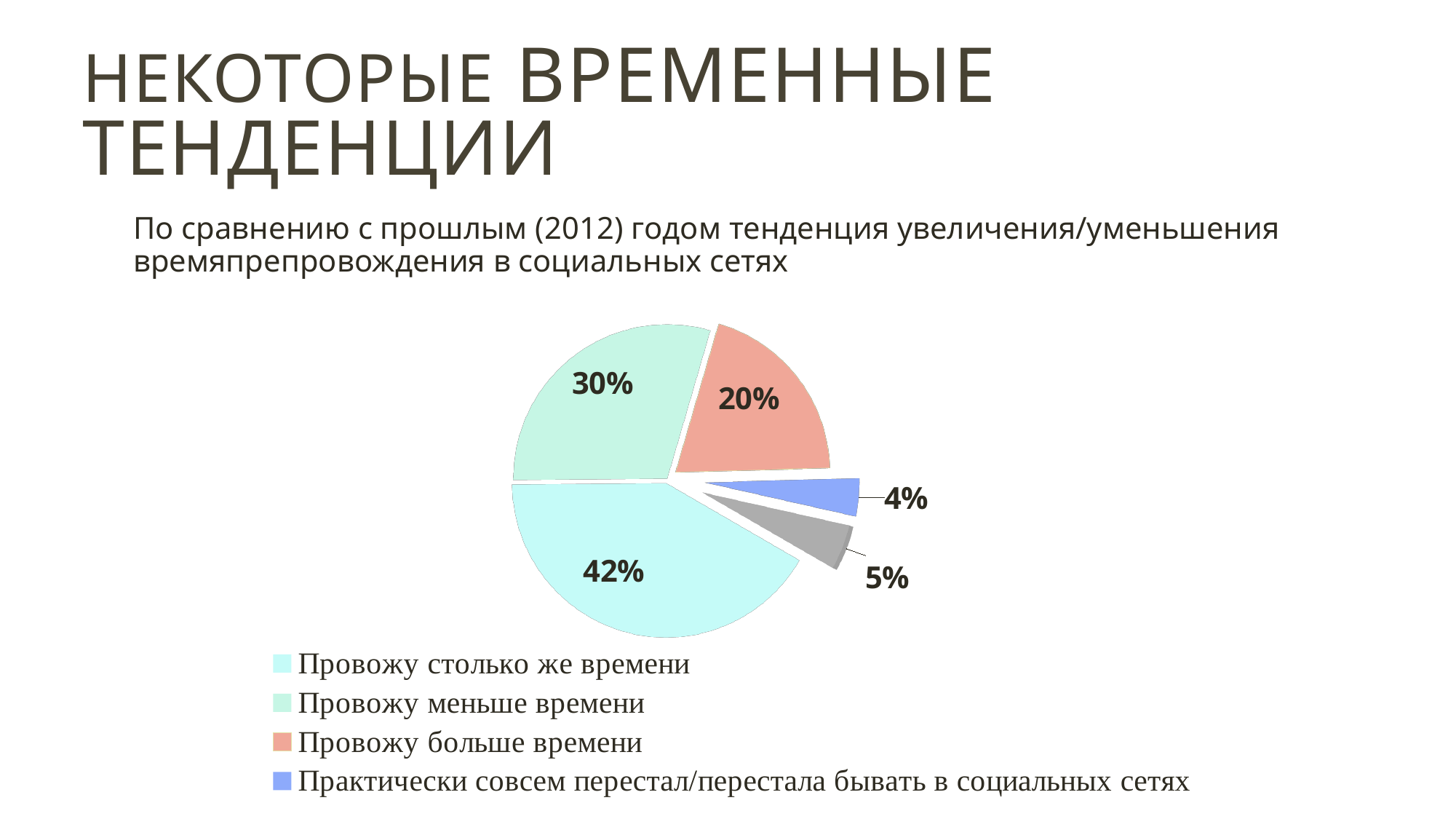
What colour is the slice for "Провожу больше времени"? salmon (pink-red) What share of the pie is labelled "Провожу столько же времени"? 42% What share of the pie is labelled "Провожу больше времени"? 20% Which is larger: the slice for "Провожу меньше времени" or the slice for "Провожу больше времени"? Провожу меньше времени What is the difference in percentage points between "Провожу столько же времени" and "Провожу меньше времени"? 12 What kind of chart is shown on the slide? pie chart How many slices does the pie chart have? 5 Which legend category has the smallest slice of the pie? Практически совсем перестал/перестала бывать в социальных сетях How many entries does the legend list? 4 Which category has the largest slice of the pie? Провожу столько же времени What share of the pie is labelled "Практически совсем перестал/перестала бывать в социальных сетях"? 4% What share of the pie is labelled "Провожу меньше времени"? 30%